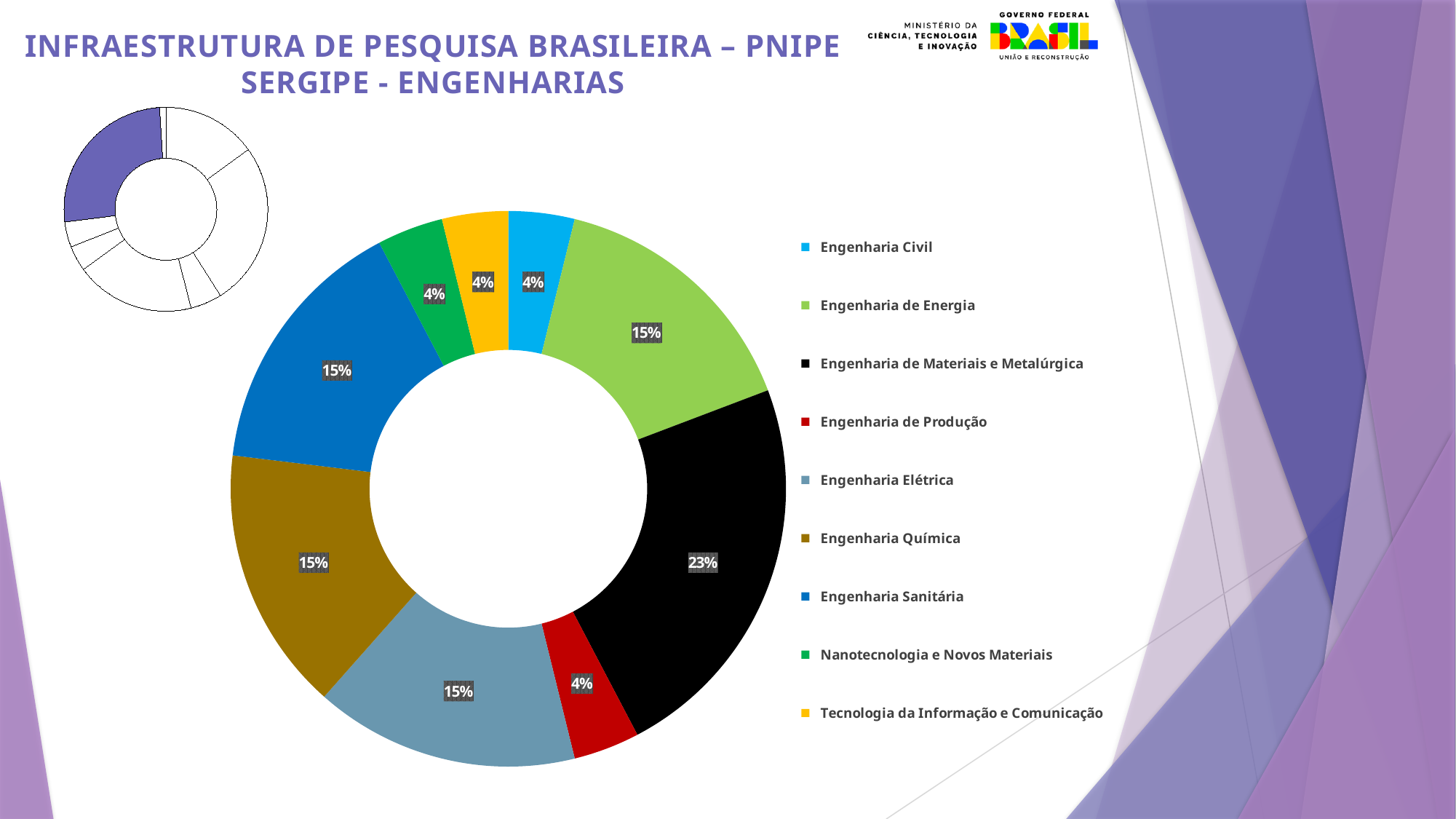
In the large doughnut chart, which category is shown in yellow? Tecnologia da Informação e Comunicação In the large doughnut chart, what is the share for Engenharia Química? 15% How many categories does the legend of the large doughnut chart list? 9 What kind of chart is the large chart on the slide? Doughnut chart In the large doughnut chart, what is the share for Engenharia Civil? 4% In the large doughnut chart, which category has the largest share? Engenharia de Materiais e Metalúrgica In the large doughnut chart, what is the share for Nanotecnologia e Novos Materiais? 4% In the large doughnut chart, what is the difference between the shares of Engenharia de Materiais e Metalúrgica and Engenharia Sanitária? 8% In the large doughnut chart, what is the share for Engenharia de Materiais e Metalúrgica? 23% In the large doughnut chart, which is larger: the share for Engenharia de Energia or the share for Engenharia de Produção? Engenharia de Energia In the large doughnut chart, what colour is the segment for Engenharia Elétrica? Grey-blue In the large doughnut chart, how many categories have a share of 15%? 4